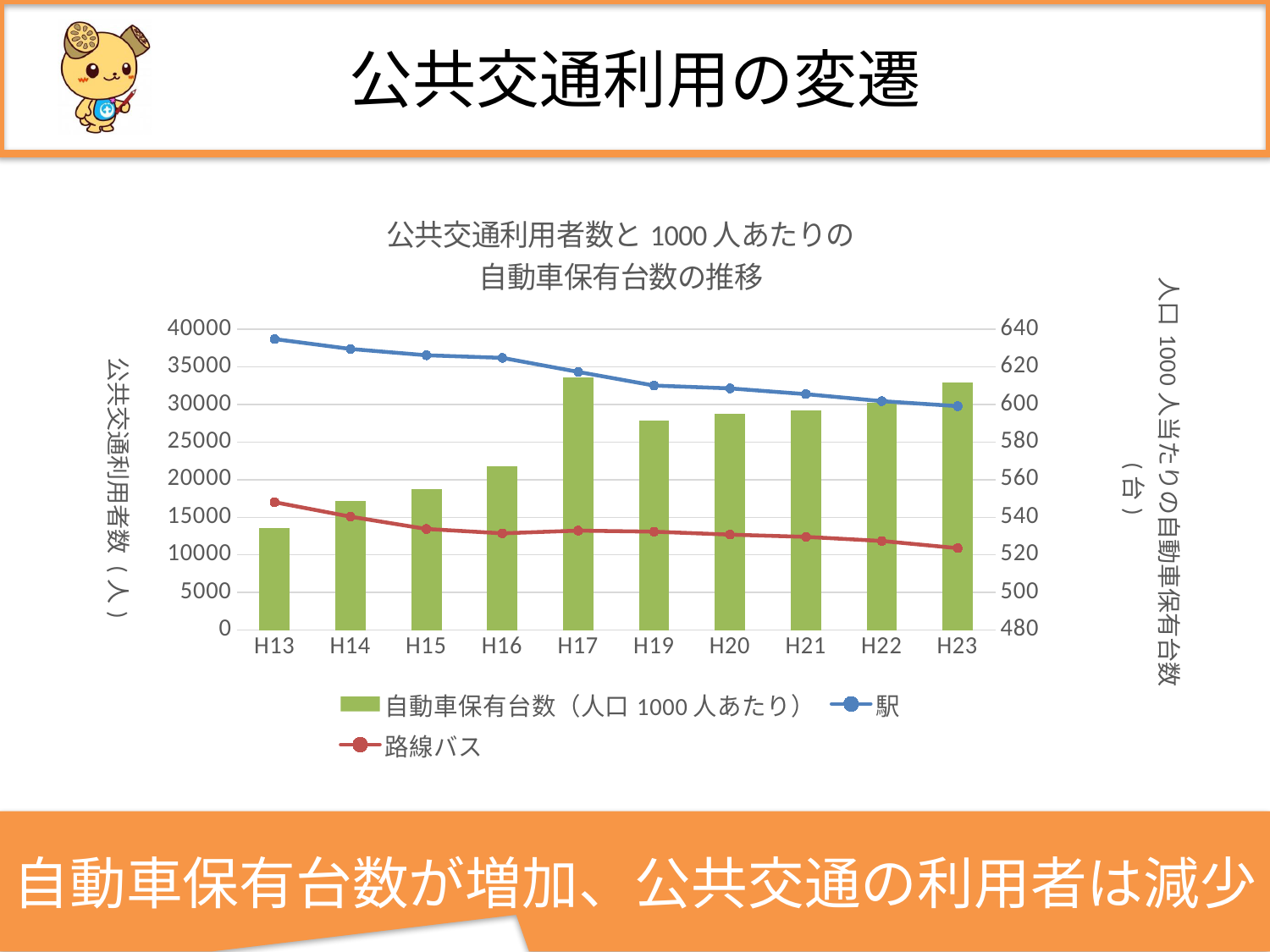
Is the 路線バス value for H23 greater or less than 15000? less What kind of chart is shown on the slide? Combined bar and line chart Is the 駅 value for H13 greater or less than 35000? greater In which year is the 自動車保有台数 bar the lowest? H13 In which year is the 駅 line at its lowest? H23 How many years are shown on the x axis of the chart? 10 In which year is the 駅 line at its highest? H13 Which is larger at H13, the 駅 value or the 路線バス value? 駅 What is the title of the chart? 公共交通利用者数と1000人あたりの自動車保有台数の推移 Does the 路線バス line rise or fall from H13 to H23? Fall How many series does the chart legend list? 3 Which series is drawn as green bars in the chart? 自動車保有台数（人口1000人あたり）